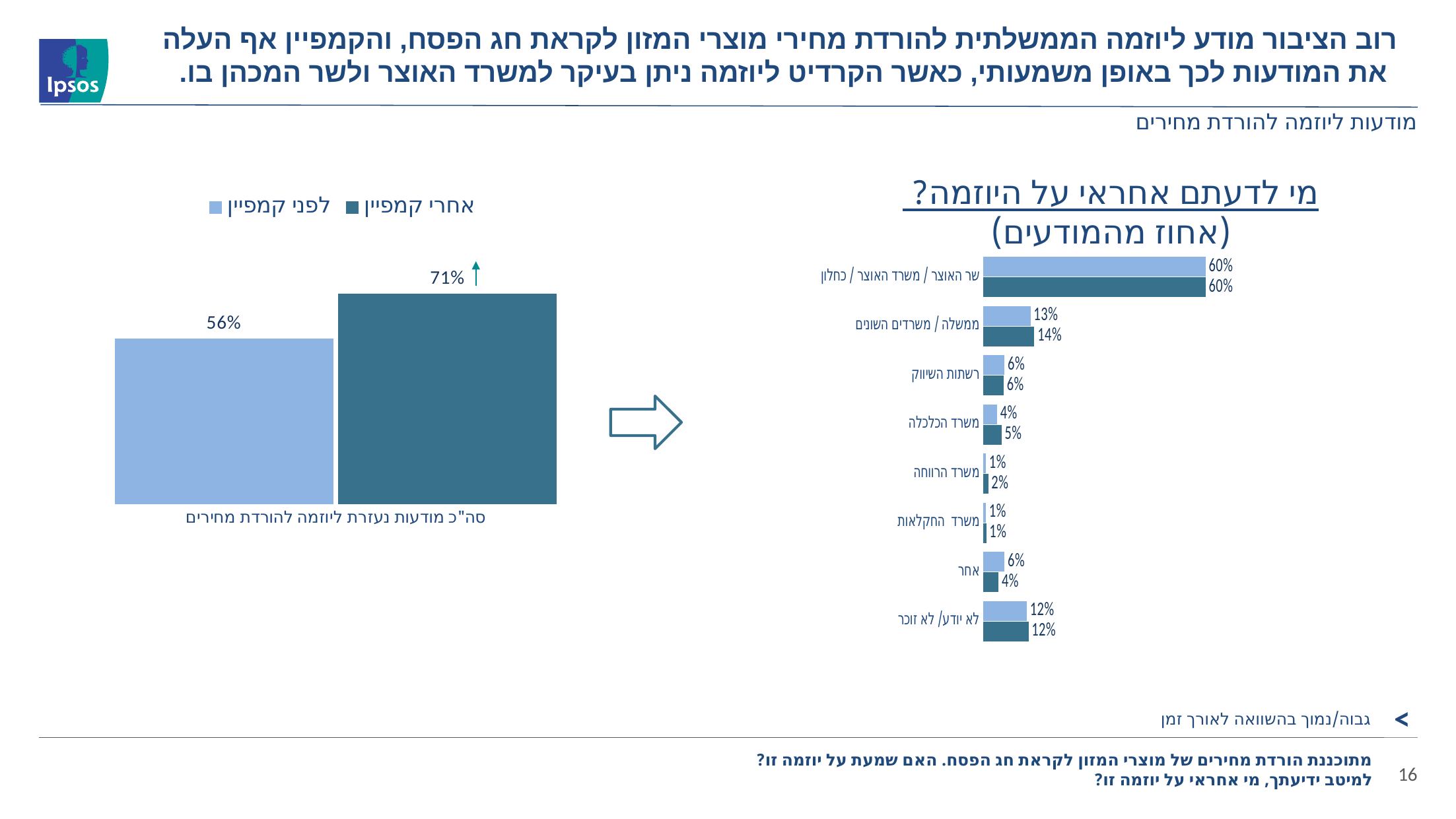
In the left chart, what is the value for אחרי קמפיין? 71% In the right chart (מי לדעתם אחראי על היוזמה?), how many categories are shown? 8 In the right chart (מי לדעתם אחראי על היוזמה?), what is the difference between the לפני קמפיין and אחרי קמפיין values for אחר? 2% In the left chart, what is the value for לפני קמפיין? 56% In the right chart (מי לדעתם אחראי על היוזמה?), what is the אחרי קמפיין value for ממשלה / משרדים השונים? 14% In the right chart (מי לדעתם אחראי על היוזמה?), what is the אחרי קמפיין value for משרד הכלכלה? 5% How many series does the legend list? 2 In the right chart (מי לדעתם אחראי על היוזמה?), what is the לפני קמפיין value for לא יודע/ לא זוכר? 12% In the left chart, what is the difference between the אחרי קמפיין and לפני קמפיין values? 15% In the right chart (מי לדעתם אחראי על היוזמה?), which category has the highest value? שר האוצר / משרד האוצר / כחלון What kind of chart is the chart on the right (מי לדעתם אחראי על היוזמה?)? Bar chart In the left chart, which is larger: לפני קמפיין or אחרי קמפיין? אחרי קמפיין